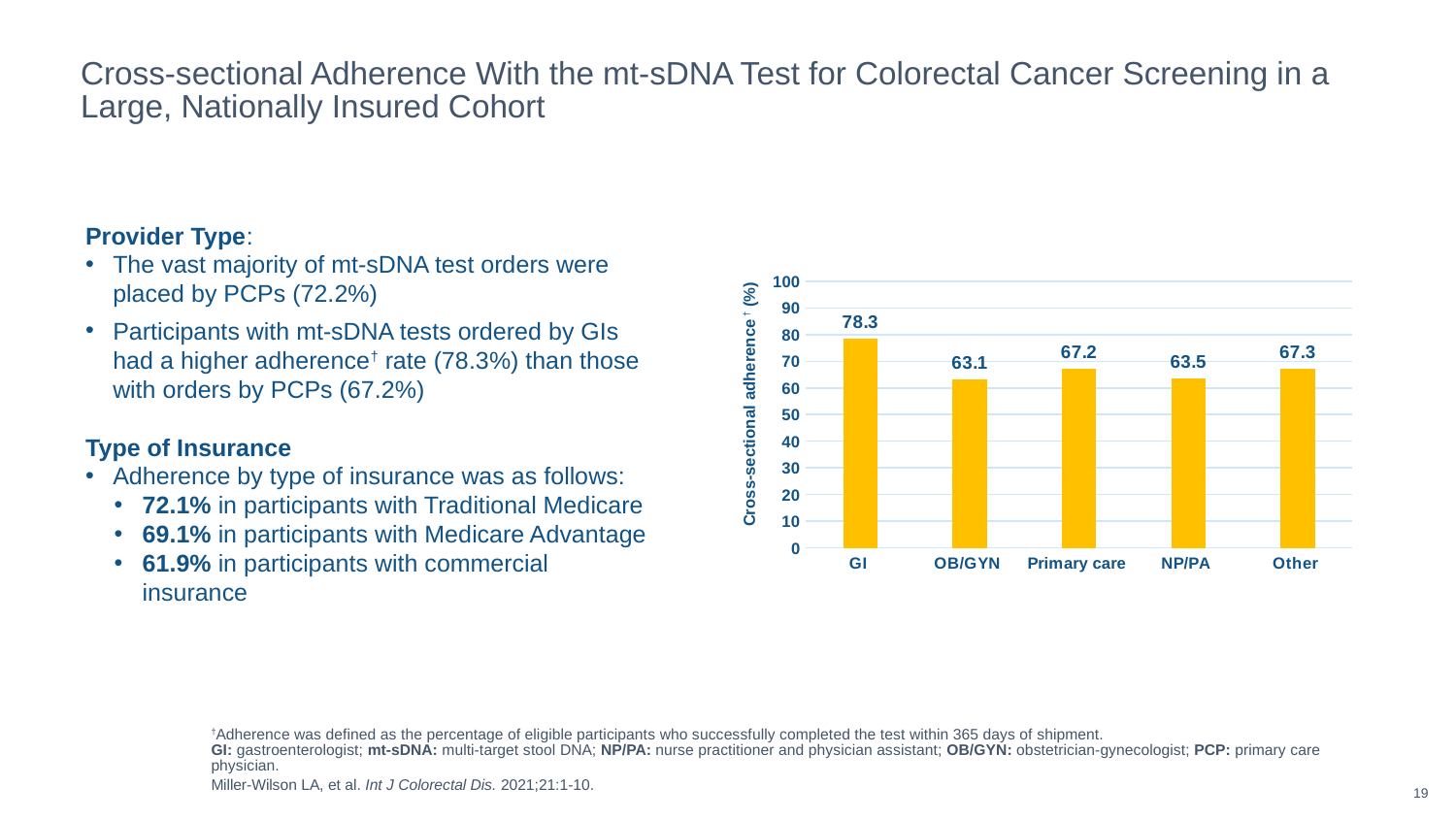
What is the difference in cross-sectional adherence between GI and Primary care? 11.1 What kind of chart is shown on the slide? Bar chart Which provider type has the highest cross-sectional adherence? GI What is the cross-sectional adherence value for GI? 78.3 What is the cross-sectional adherence value for Primary care? 67.2 What is the cross-sectional adherence value for OB/GYN? 63.1 What is the cross-sectional adherence value for NP/PA? 63.5 Which provider type has the lowest cross-sectional adherence? OB/GYN How many provider type categories are shown on the x axis? 5 What is the label of the y axis of the chart? Cross-sectional adherence (%) Is the value for Other greater or less than 60? greater Which has a higher cross-sectional adherence, Primary care or NP/PA? Primary care